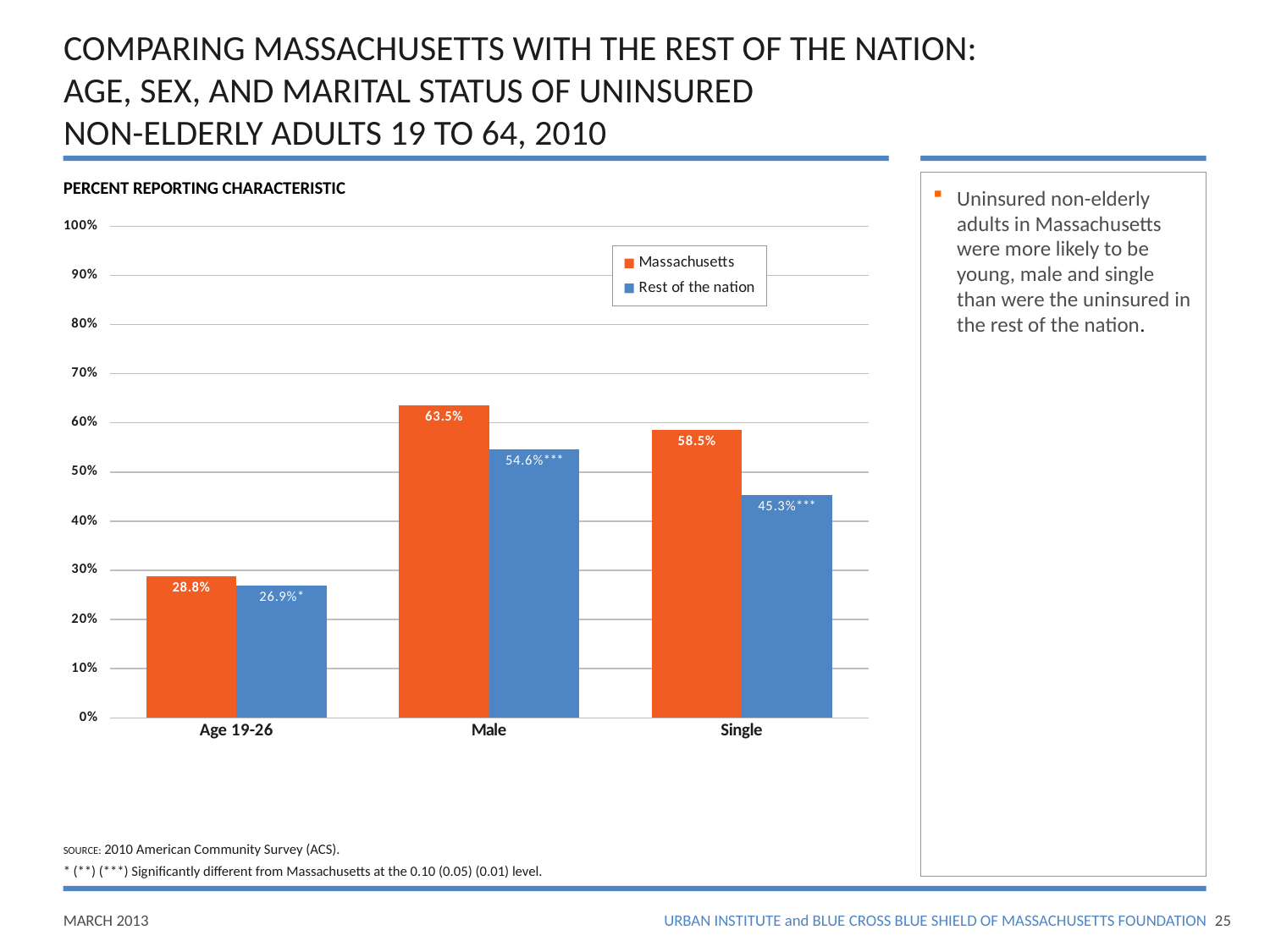
How many series does the legend list? 2 What is the difference between Massachusetts and Rest of the nation in the Single category? 13.2% What is the value for Rest of the nation in the Single category? 45.3% Which is larger in the Male category: Massachusetts or Rest of the nation? Massachusetts Which category has the lowest value for Rest of the nation? Age 19-26 What is the value for Massachusetts in the Male category? 63.5% How many categories are shown on the x axis? 3 Which category has the highest value for Massachusetts? Male What kind of chart is shown on the slide? Bar chart What is the value for Rest of the nation in the Age 19-26 category? 26.9% What is the value for Massachusetts in the Age 19-26 category? 28.8% Which colour represents Rest of the nation in the chart? Blue